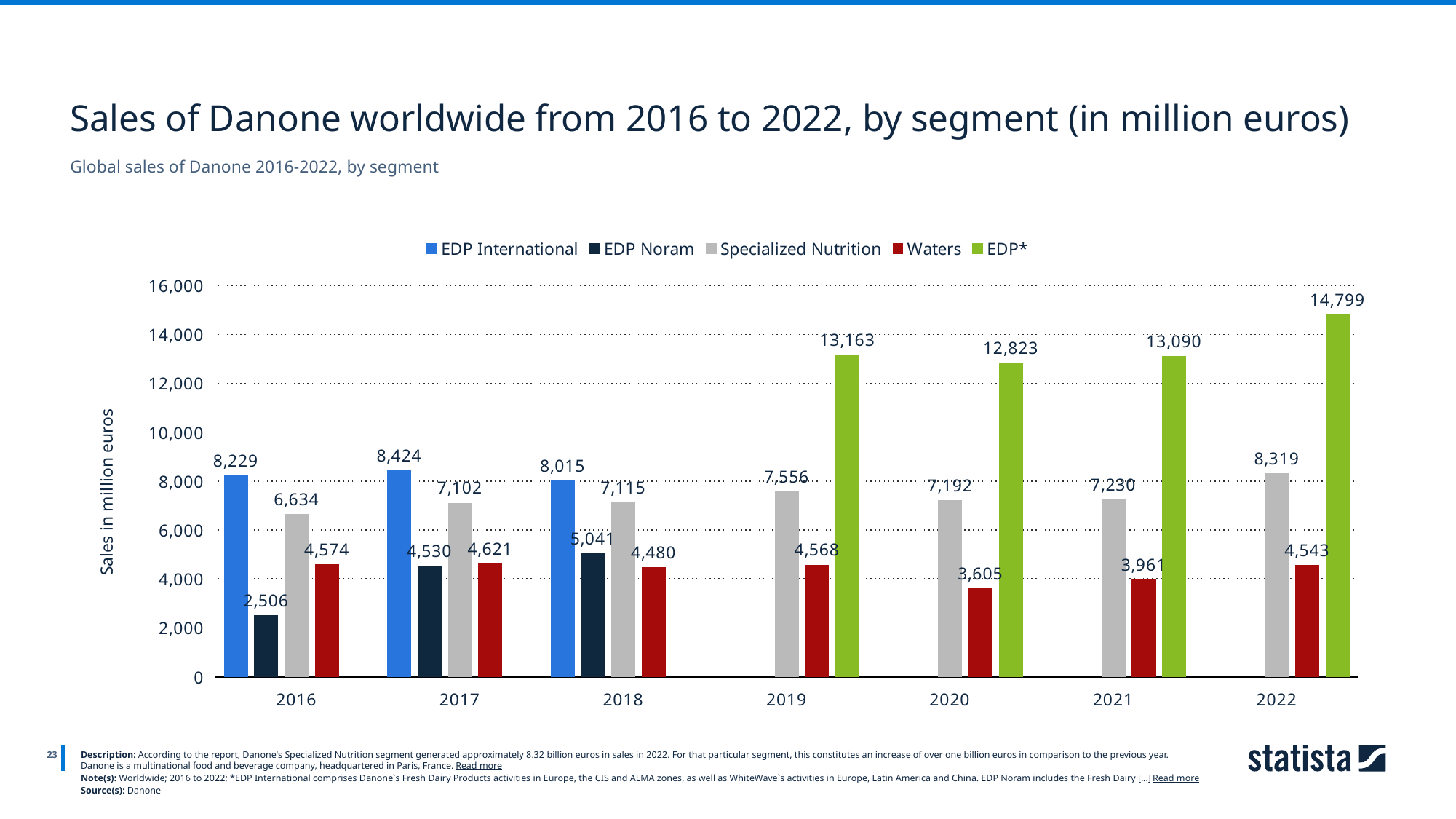
What were Danone's Specialized Nutrition sales in 2019, in million euros? 7,556 What kind of chart is shown on the slide? Bar chart What is the difference between Specialized Nutrition sales in 2022 and 2021, in million euros? 1,089 In which year were Danone's EDP* sales the highest? 2022 Which was larger in 2017: EDP International sales or Specialized Nutrition sales? EDP International In which year were Danone's Waters sales the lowest? 2020 What is the label of the y axis? Sales in million euros What were Danone's EDP Noram sales in 2016, in million euros? 2,506 Was the value for EDP* in 2020 greater or less than 12,000? greater What were Danone's EDP* sales in 2022, in million euros? 14,799 How many years are shown on the x axis? 7 How many series does the legend list? 5